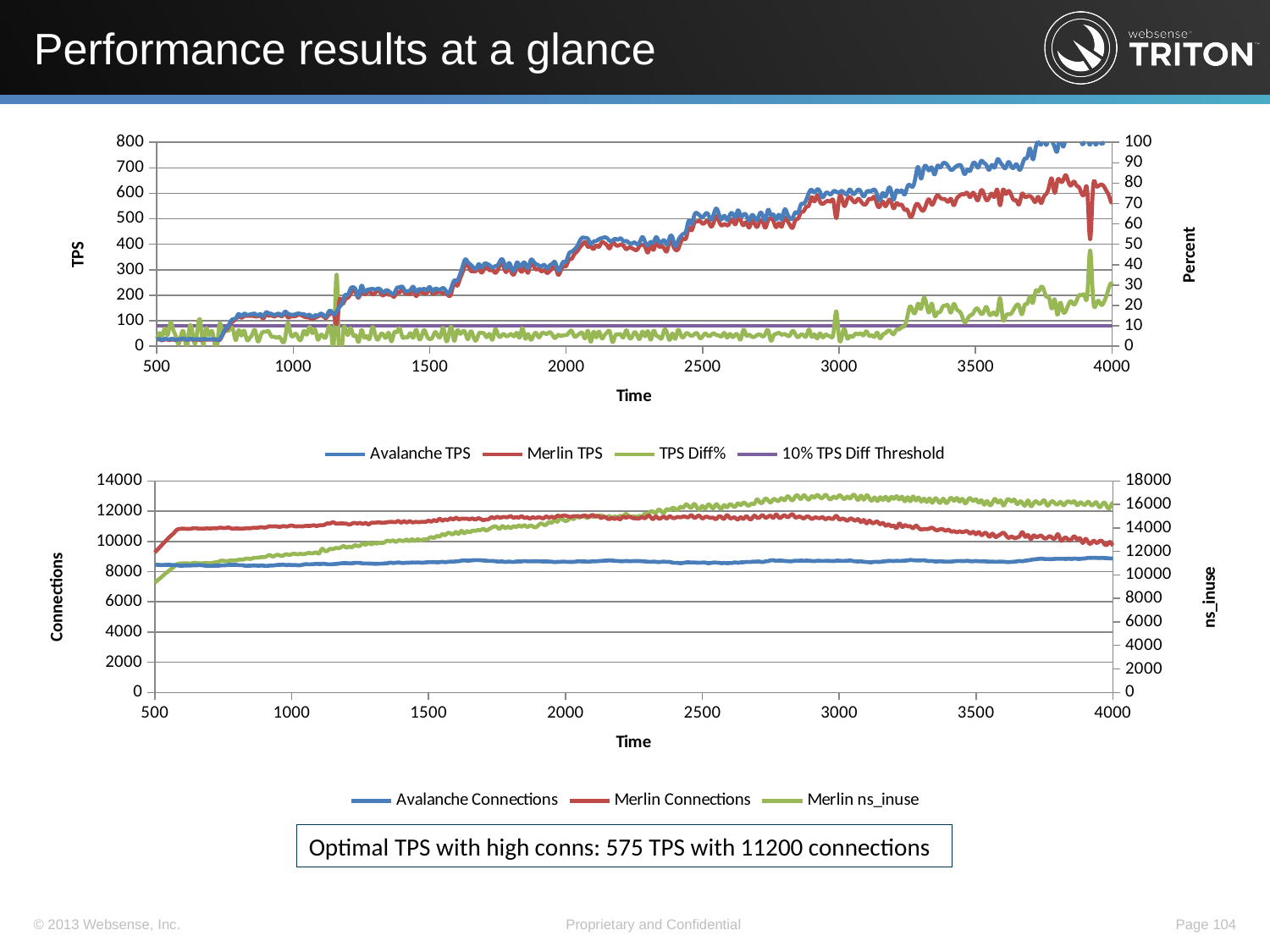
In the top chart, does Avalanche TPS rise or fall as time increases from 500 to 4000? rise In the top chart, is the value of Avalanche TPS at time 4000 greater or less than 700? greater What is the title of the right-hand vertical axis of the bottom chart? ns_inuse In the top chart, at time 4000, which is larger: Avalanche TPS or Merlin TPS? Avalanche TPS In the top chart, is the value of Merlin TPS at time 2000 greater or less than 400? less How many series does the legend of the bottom chart list? 3 In the bottom chart, at time 2000, which is larger: Merlin Connections or Avalanche Connections? Merlin Connections What kind of chart is the top chart on the slide? line chart In the bottom chart, is the value of Merlin Connections at time 2500 greater or less than 10000? greater How many series does the legend of the top chart list? 4